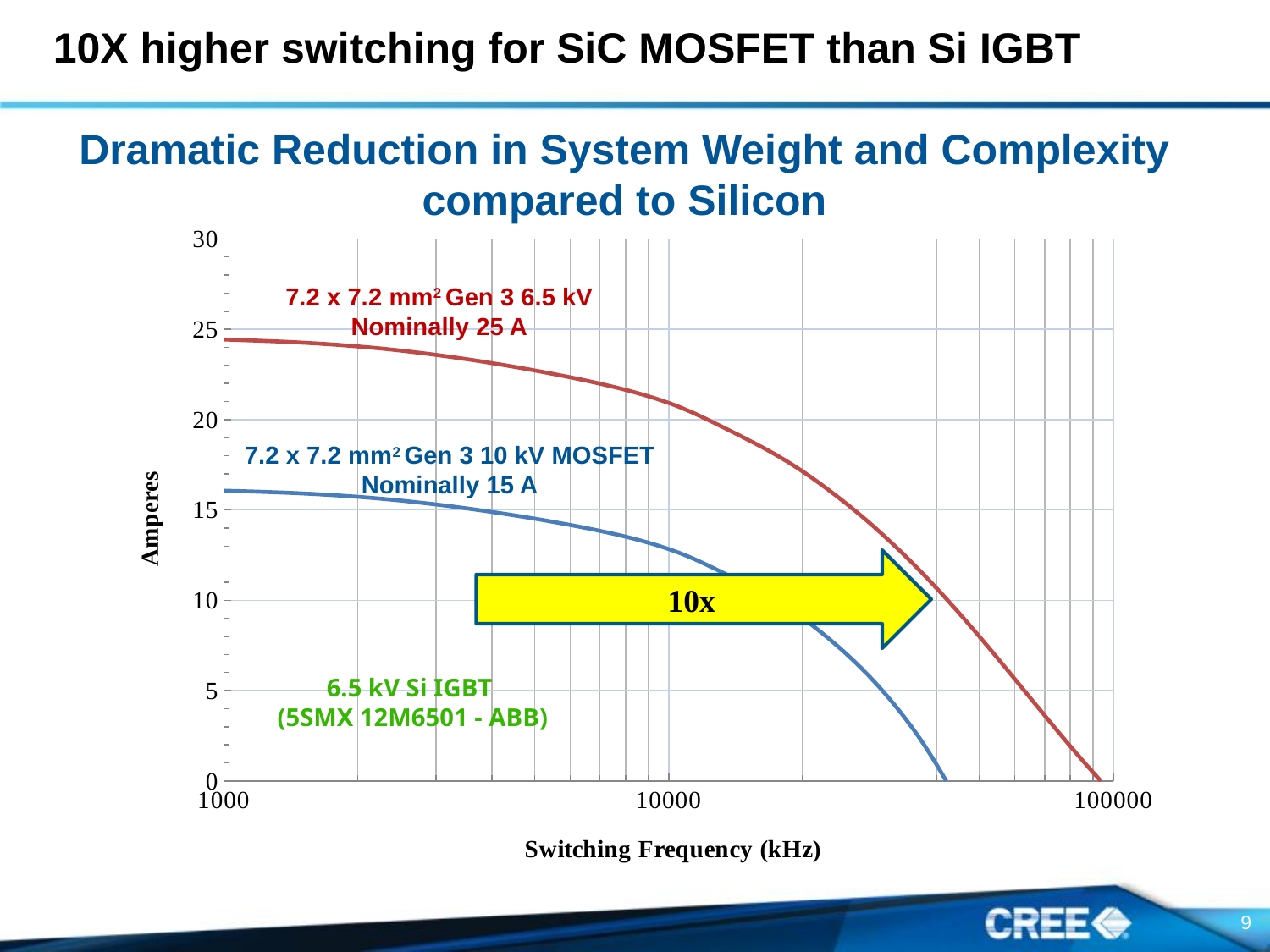
What nominal current is stated for the 7.2 x 7.2 mm² Gen 3 6.5 kV device? Nominally 25 A Is the value of the blue 10 kV MOSFET curve at 1000 kHz greater or less than 15 amperes? greater Is the value of the red 6.5 kV curve at 10000 kHz greater or less than 20 amperes? greater At 10000 kHz, which curve is higher: the red 6.5 kV curve or the blue 10 kV MOSFET curve? the red 6.5 kV curve Is the value of the blue 10 kV MOSFET curve at 1000 kHz greater or less than 20 amperes? less What kind of chart is shown on the slide? line chart Which curve reaches 0 amperes at a lower switching frequency: the red 6.5 kV curve or the blue 10 kV MOSFET curve? the blue 10 kV MOSFET curve Do the curves rise or fall as switching frequency increases along the x axis? fall What is the title of the y axis of the chart? Amperes